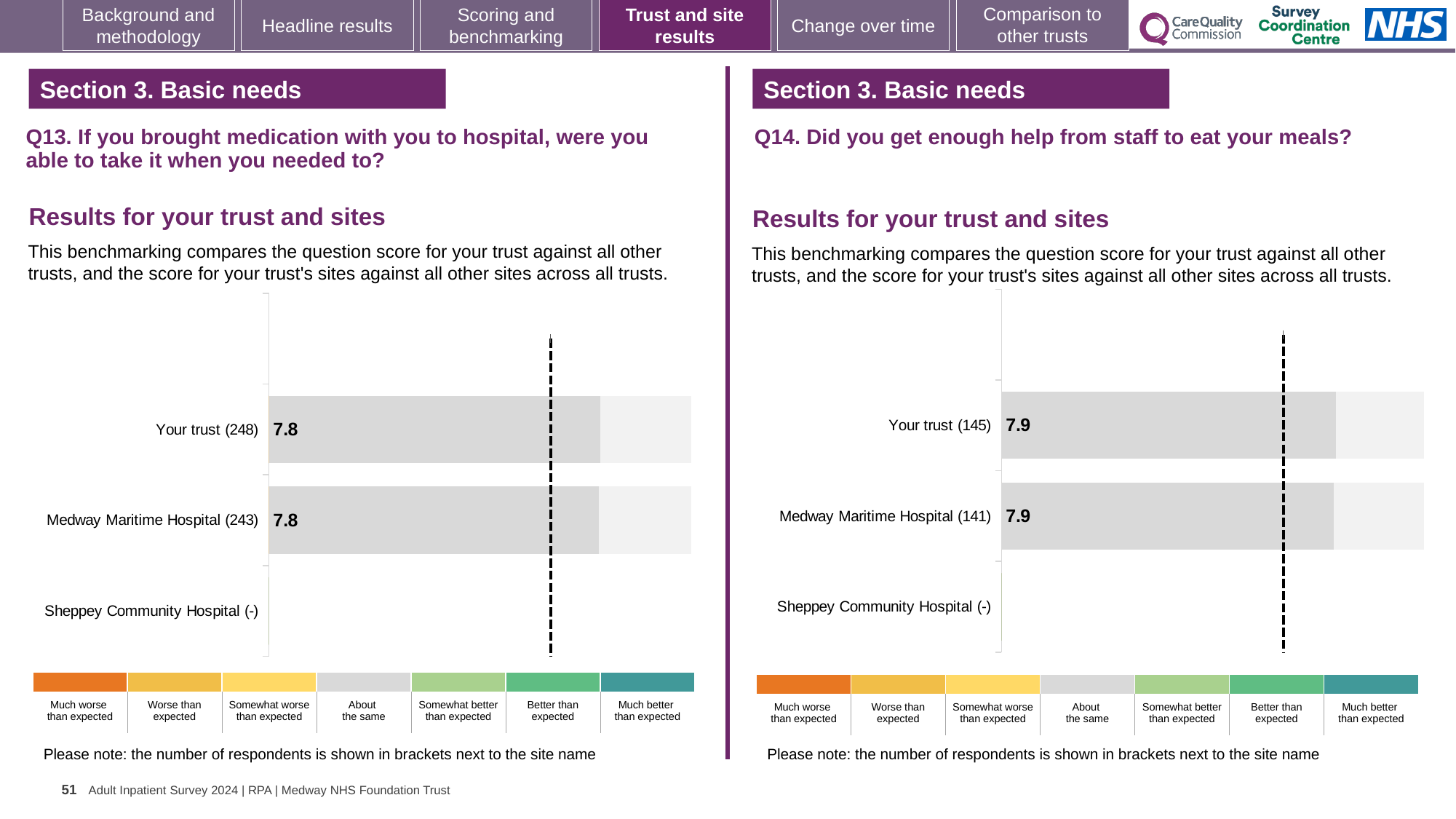
On the Q14 chart (right), what is the score for Your trust? 7.9 How many categories are listed on the Q13 chart (left)? 3 On the Q14 chart (right), what is the score for Medway Maritime Hospital? 7.9 On the Q13 chart (left), what is the difference between the scores for Your trust and Medway Maritime Hospital? 0.0 What kind of chart is the Q13 chart (left)? Bar chart On the Q13 chart (left), how many respondents are shown in brackets for Your trust? 248 On the Q13 chart (left), what is the score for Your trust? 7.8 How many categories are listed on the Q14 chart (right)? 3 On the Q14 chart (right), what is the difference between the scores for Your trust and Medway Maritime Hospital? 0.0 On the Q14 chart (right), which category has no score shown? Sheppey Community Hospital On the Q14 chart (right), how many respondents are shown in brackets for Medway Maritime Hospital? 141 On the Q13 chart (left), what is the score for Medway Maritime Hospital? 7.8